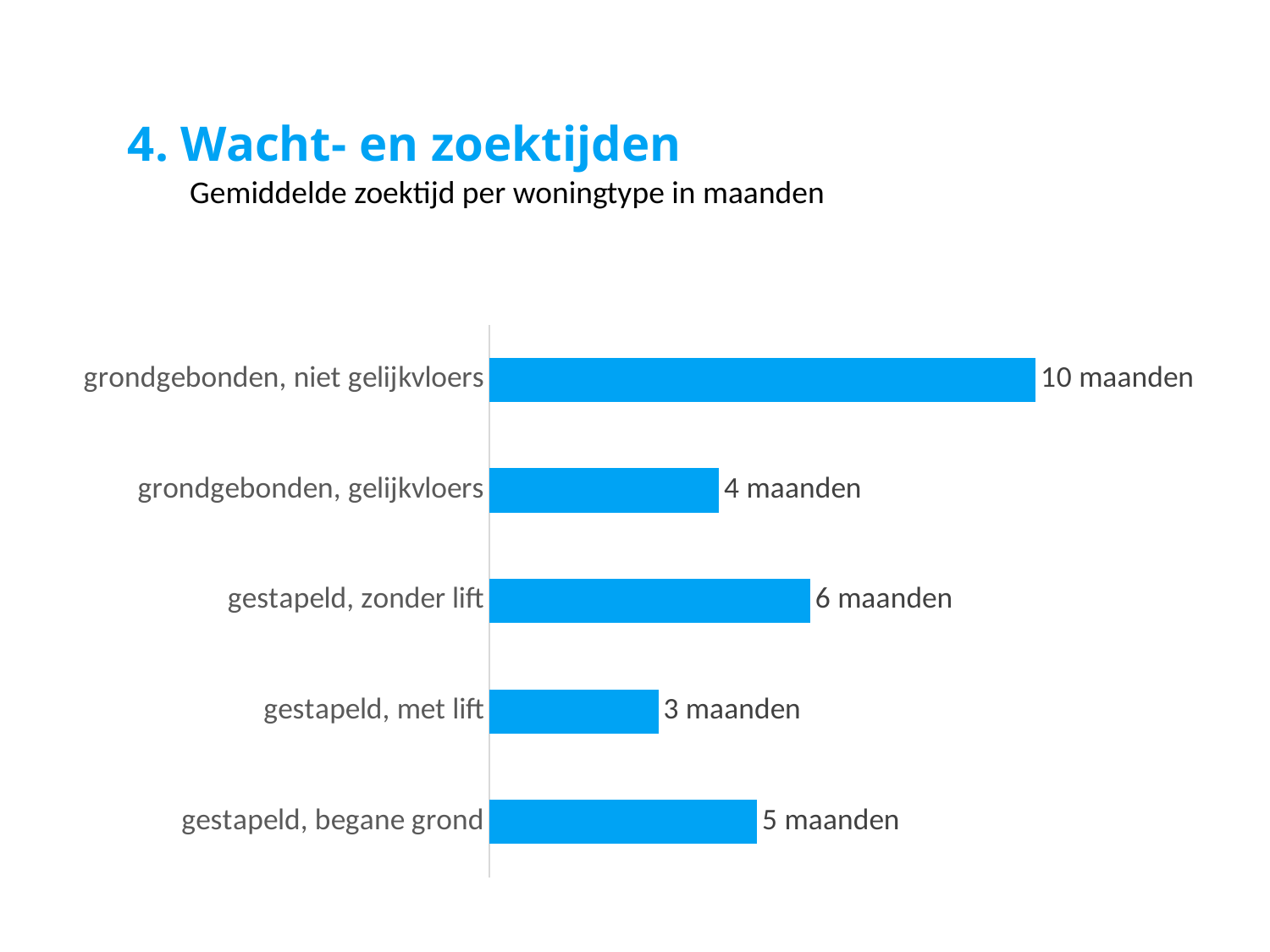
Which has a longer average search time: 'gestapeld, zonder lift' or 'grondgebonden, gelijkvloers'? gestapeld, zonder lift What is the average search time for 'grondgebonden, niet gelijkvloers'? 10 maanden What is the difference in search time between 'gestapeld, begane grond' and 'gestapeld, met lift'? 2 maanden What is the subtitle of the chart on the slide? Gemiddelde zoektijd per woningtype in maanden Which housing type has the shortest average search time? gestapeld, met lift What is the average search time for 'gestapeld, begane grond'? 5 maanden What is the average search time for 'gestapeld, met lift'? 3 maanden What kind of chart is shown on the slide? bar chart What is the average search time for 'grondgebonden, gelijkvloers'? 4 maanden Which housing type has the longest average search time? grondgebonden, niet gelijkvloers How many months longer is the search time for 'grondgebonden, niet gelijkvloers' than for 'gestapeld, zonder lift'? 4 maanden How many housing types are shown in the chart? 5